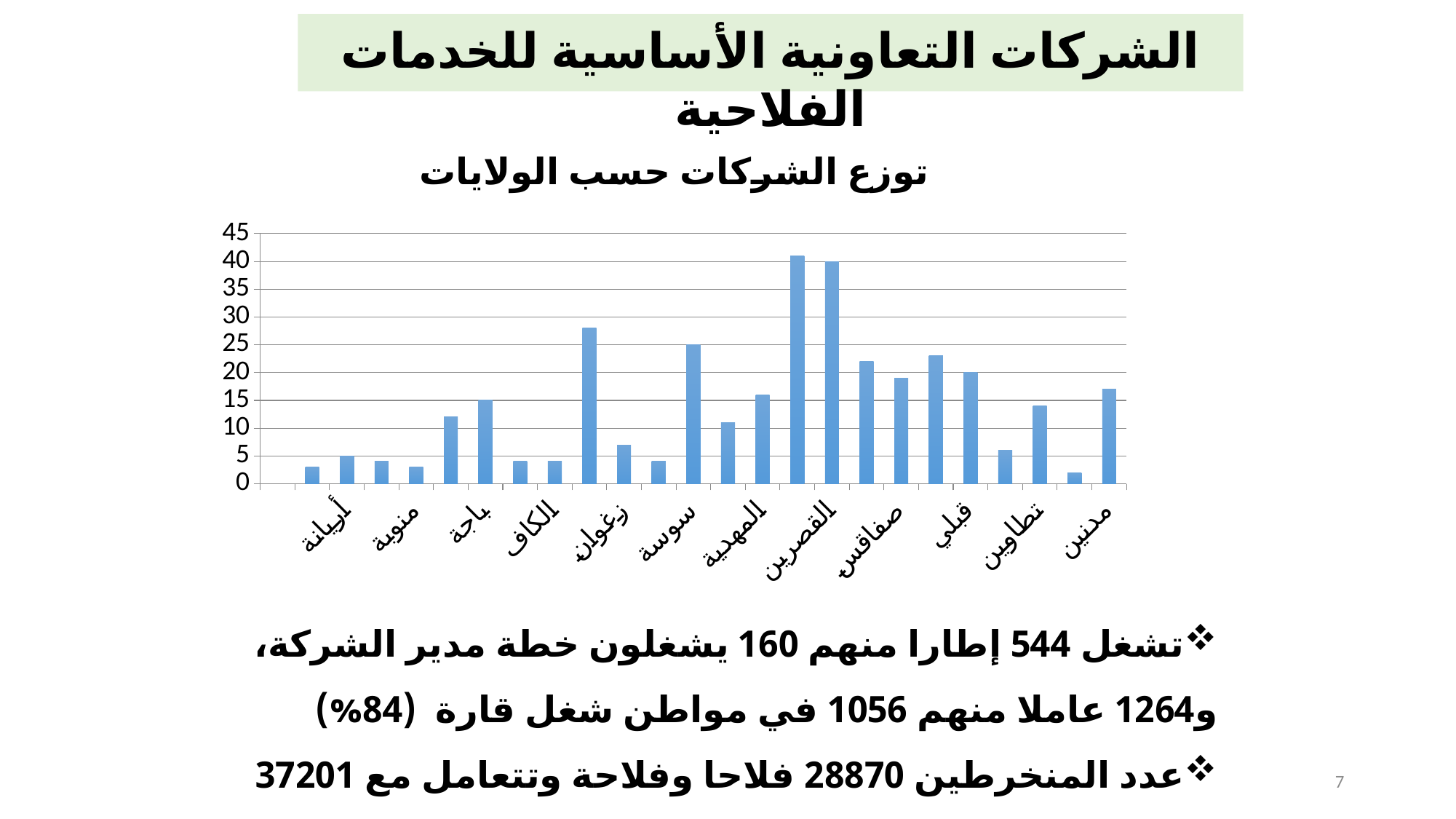
Is the value for زغوان greater or less than 25? less What is the title of the chart? توزع الشركات حسب الولايات Is the value for تطاوين greater or less than 10? greater Which has a larger value, القصرين or صفاقس? القصرين What colour are the bars in the chart? blue Is the value for باجة greater or less than 10? greater Which labelled category has the lowest bar in the chart? منوبة Which has a larger value, زغوان or سوسة? سوسة What kind of chart is shown on the slide? bar chart